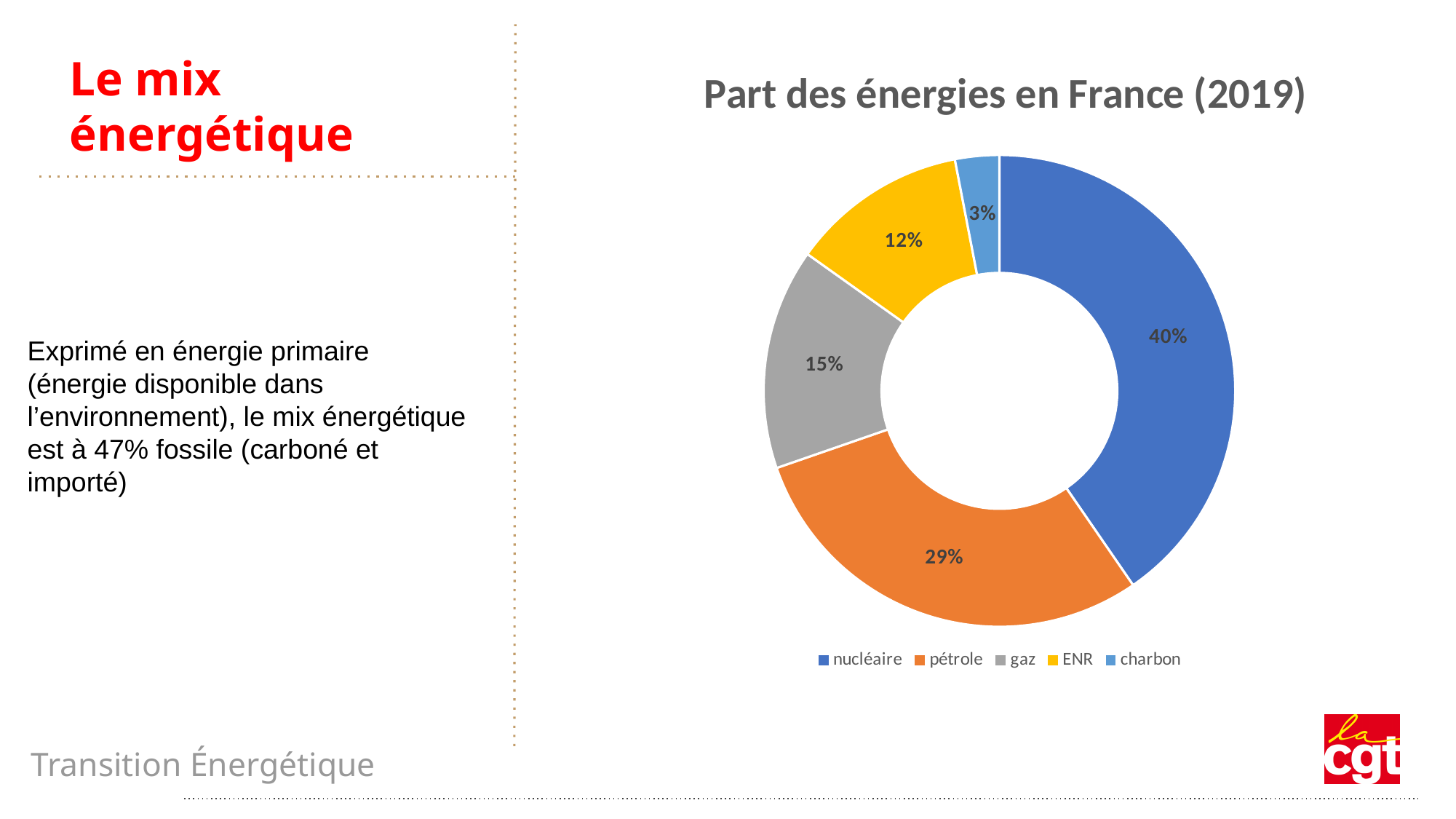
What is the value shown for ENR? 12% What is the difference between the shares of nucléaire and pétrole? 11% What is the title of the chart? Part des énergies en France (2019) What kind of chart is shown on the slide? doughnut chart How many categories are shown in the chart? 5 Which is larger, the share of gaz or the share of ENR? gaz What is the value shown for pétrole? 29% Which energy source has the smallest share? charbon What is the value shown for gaz? 15% Which energy source has the largest share? nucléaire What is the value shown for charbon? 3% What share of the chart does nucléaire represent? 40%